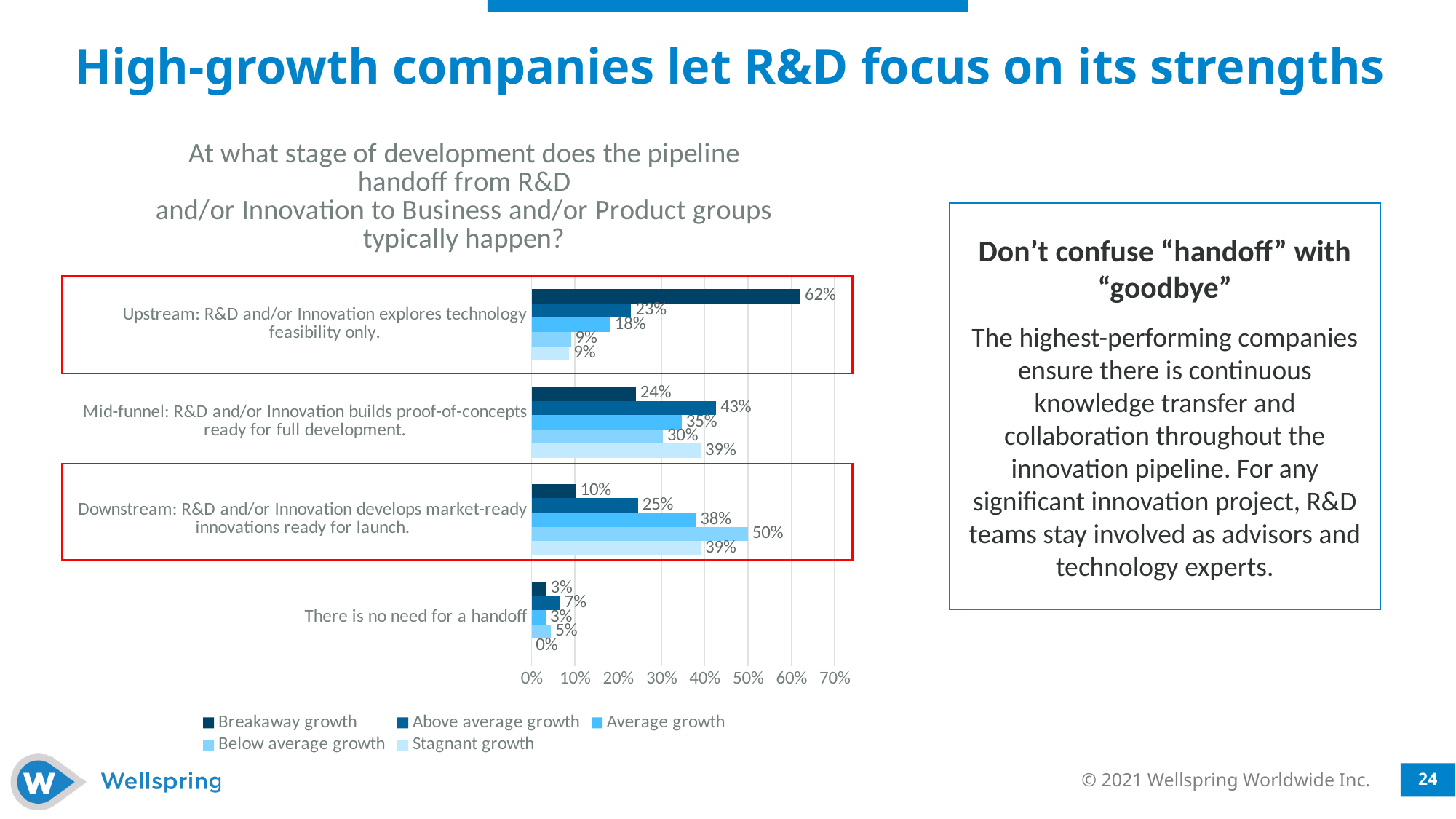
Which category has the highest Breakaway growth value? Upstream: R&D and/or Innovation explores technology feasibility only. How many series does the legend list? 5 What kind of chart is shown on the slide? Bar chart What is the difference between the Breakaway growth value for Upstream and the Breakaway growth value for Downstream? 52% Which category has the lowest Below average growth value? There is no need for a handoff Which series is shown in the darkest blue colour in the legend? Breakaway growth What is the Below average growth value for the Downstream category? 50% For the Mid-funnel category, which is larger: the Breakaway growth value or the Stagnant growth value? Stagnant growth How many categories (handoff stages) are plotted on the chart? 4 What is the Above average growth value for the Mid-funnel category? 43% What is the Stagnant growth value for 'There is no need for a handoff'? 0% What is the Breakaway growth value for the Upstream category? 62%